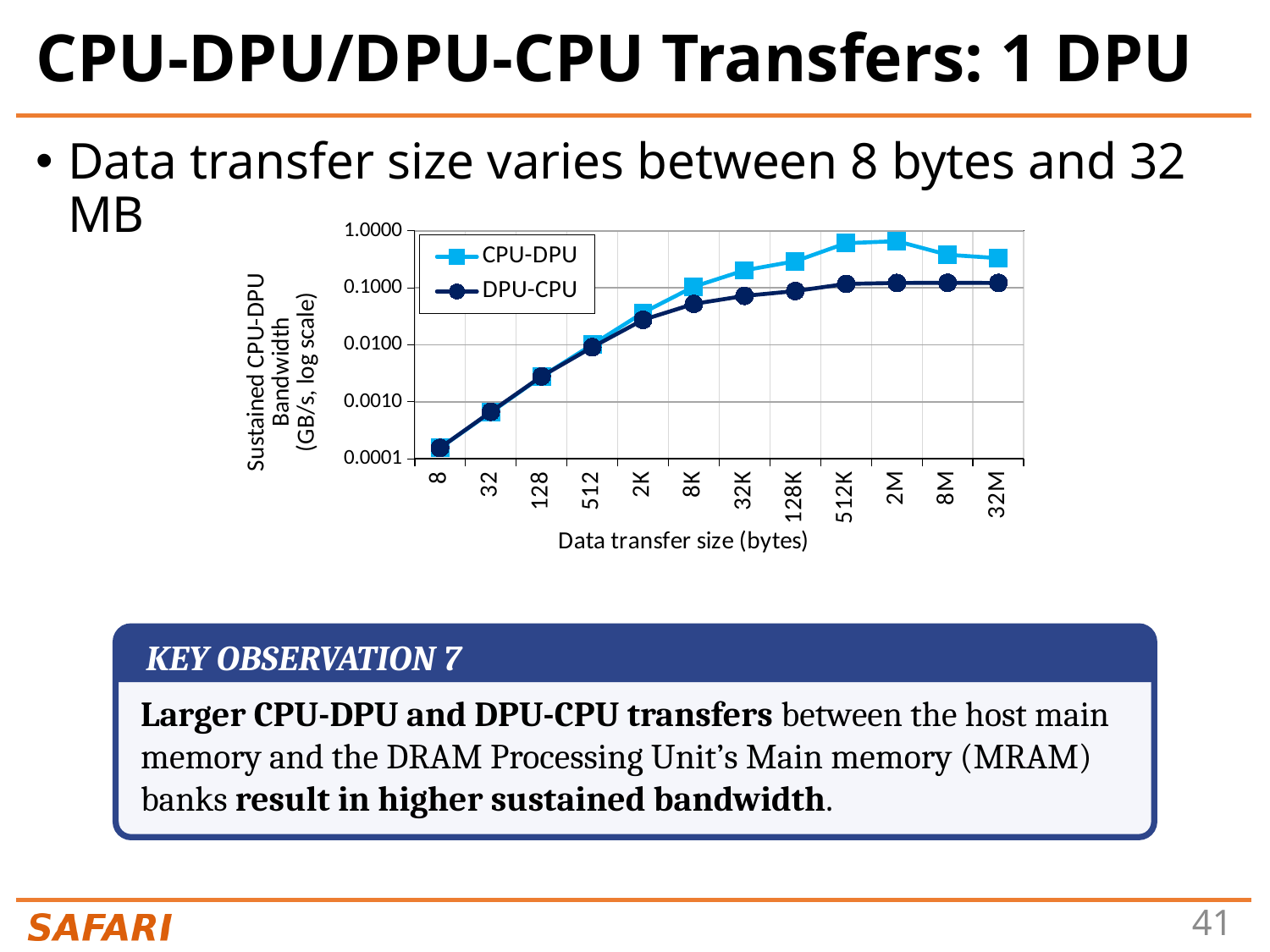
Which series does the legend show with square markers? CPU-DPU Is the CPU-DPU bandwidth at a transfer size of 2M greater or less than 0.1000 GB/s? greater How many series does the chart's legend list? 2 What is the label of the x axis? Data transfer size (bytes) How many data transfer sizes are plotted along the x axis? 12 Is the DPU-CPU bandwidth at a transfer size of 2K greater or less than 0.0100 GB/s? greater Is the DPU-CPU bandwidth at a transfer size of 8 bytes greater or less than 0.0010 GB/s? less At a data transfer size of 2M, which series has the higher sustained bandwidth, CPU-DPU or DPU-CPU? CPU-DPU Does the CPU-DPU bandwidth generally rise or fall as the data transfer size increases from 8 bytes to 512K? rise What kind of chart is shown on the slide? line chart At which data transfer size is the DPU-CPU sustained bandwidth lowest? 8